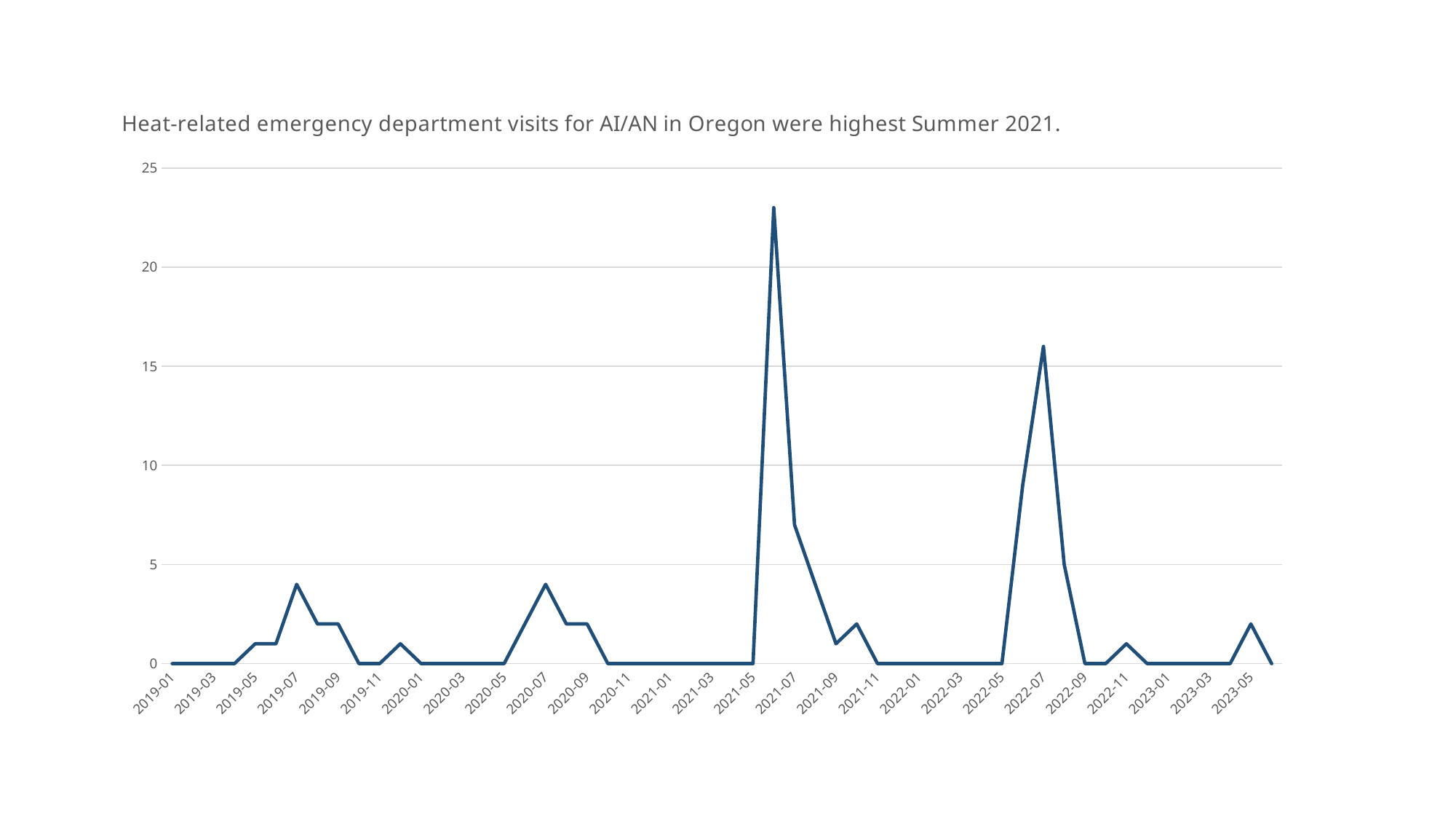
Is the value for 2022-07 greater or less than 10? greater What is the value for 2019-01? 0 Is the value for 2019-07 greater or less than 5? less According to the chart title, in which season and year were heat-related emergency department visits for AI/AN in Oregon highest? Summer 2021 What is the value for 2021-01? 0 Is the highest peak on the chart greater or less than 20? greater Do the values rise or fall from 2021-07 to 2021-09? fall What kind of chart is shown on the slide? Line chart Which has the larger value, 2021-07 or 2022-07? 2022-07 What is the title of the chart? Heat-related emergency department visits for AI/AN in Oregon were highest Summer 2021. In which year does the line reach its highest peak? 2021